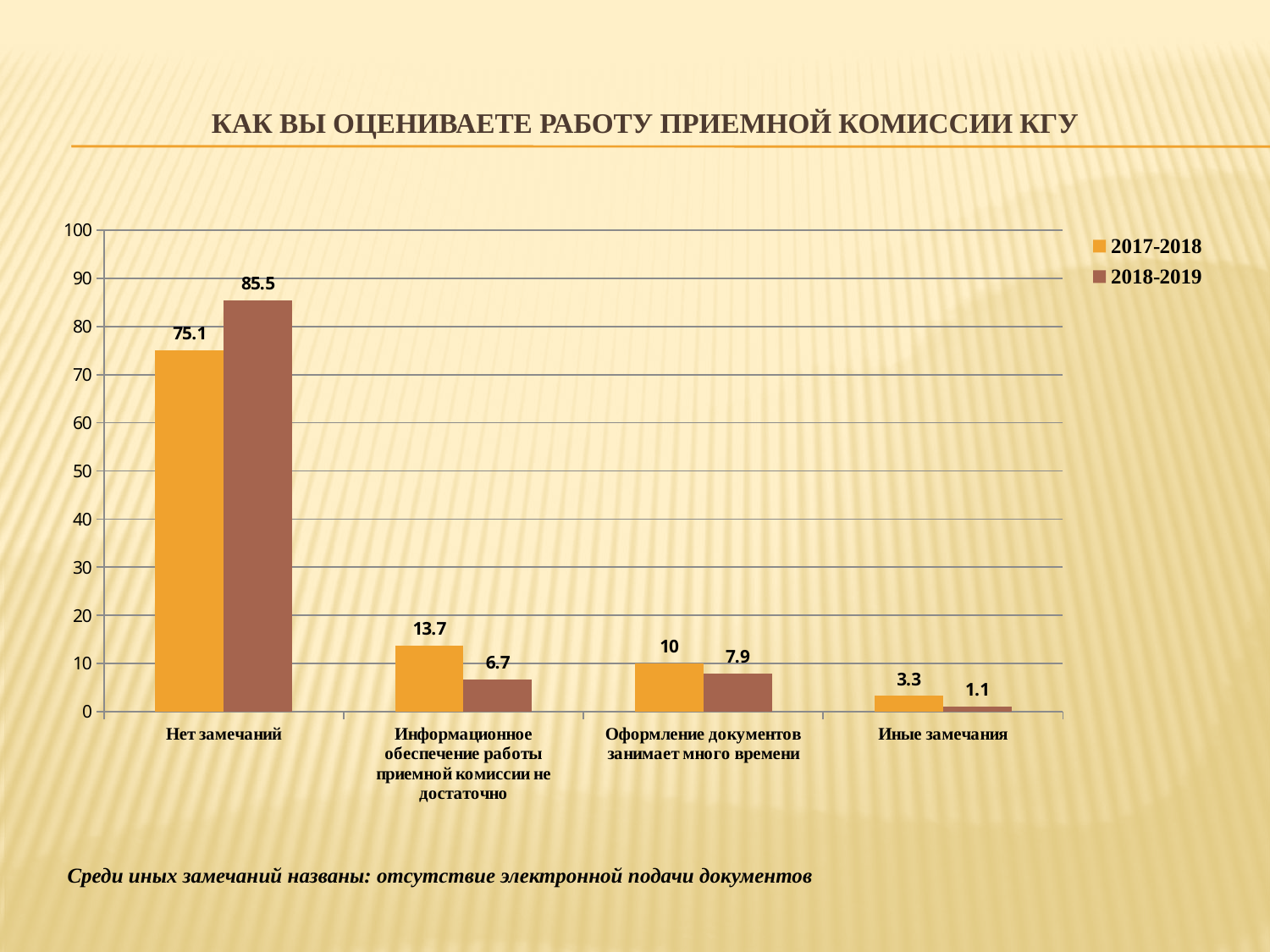
What is the value for 2017-2018 in the 'Нет замечаний' category? 75.1 What is the value for 2017-2018 in the 'Оформление документов занимает много времени' category? 10 How many categories are shown on the x axis? 4 Which category has the lowest value for the 2017-2018 series? Иные замечания What kind of chart is shown on the slide? Bar chart In the 'Информационное обеспечение работы приемной комиссии не достаточно' category, which series has the larger value, 2017-2018 or 2018-2019? 2017-2018 How many series does the legend list? 2 What is the value for 2018-2019 in the 'Иные замечания' category? 1.1 What is the value for 2018-2019 in the 'Нет замечаний' category? 85.5 What is the value for 2018-2019 in the 'Информационное обеспечение работы приемной комиссии не достаточно' category? 6.7 What is the difference between the 2018-2019 and 2017-2018 values in the 'Нет замечаний' category? 10.4 Which category has the highest value for the 2018-2019 series? Нет замечаний